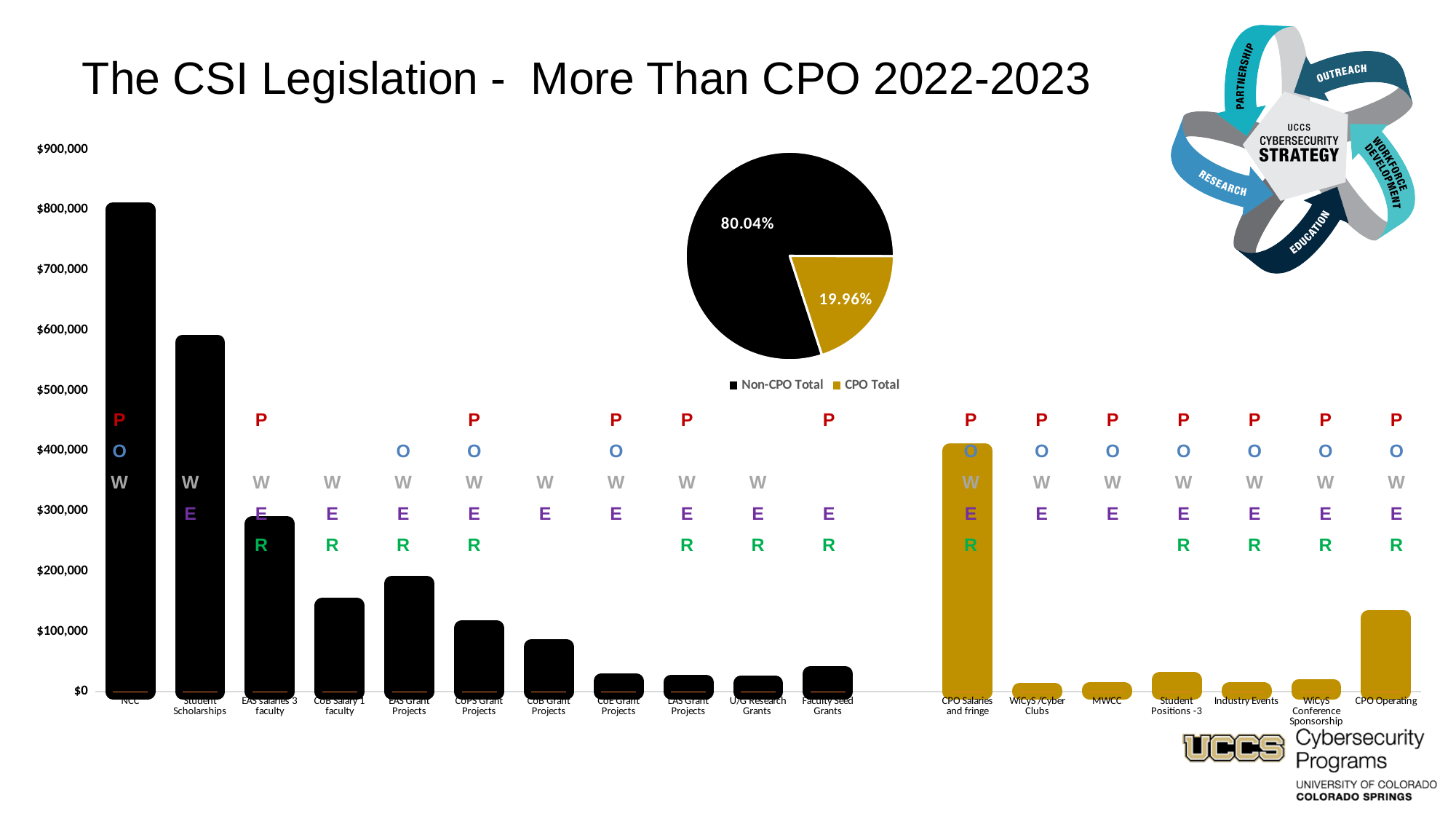
In the pie chart, what share is labelled for the Non-CPO Total slice? 80.04% In the bar chart, is the value for CPO Salaries and fringe greater or less than $300,000? greater In the bar chart, is the value for CPO Operating greater or less than $200,000? less In the bar chart, is the value for Student Scholarships greater or less than $500,000? greater How many entries does the legend of the pie chart list? 2 In the bar chart, which category has the highest value? NCC In the bar chart, which is larger, CPO Salaries and fringe or CPO Operating? CPO Salaries and fringe In the pie chart, which slice is larger, Non-CPO Total or CPO Total? Non-CPO Total In the pie chart, what share is labelled for the CPO Total slice? 19.96% What kind of chart is the large chart on the left side of the slide? Bar chart In the bar chart, which is larger, EAS Salaries 3 faculty or CoB Salary 1 faculty? EAS Salaries 3 faculty